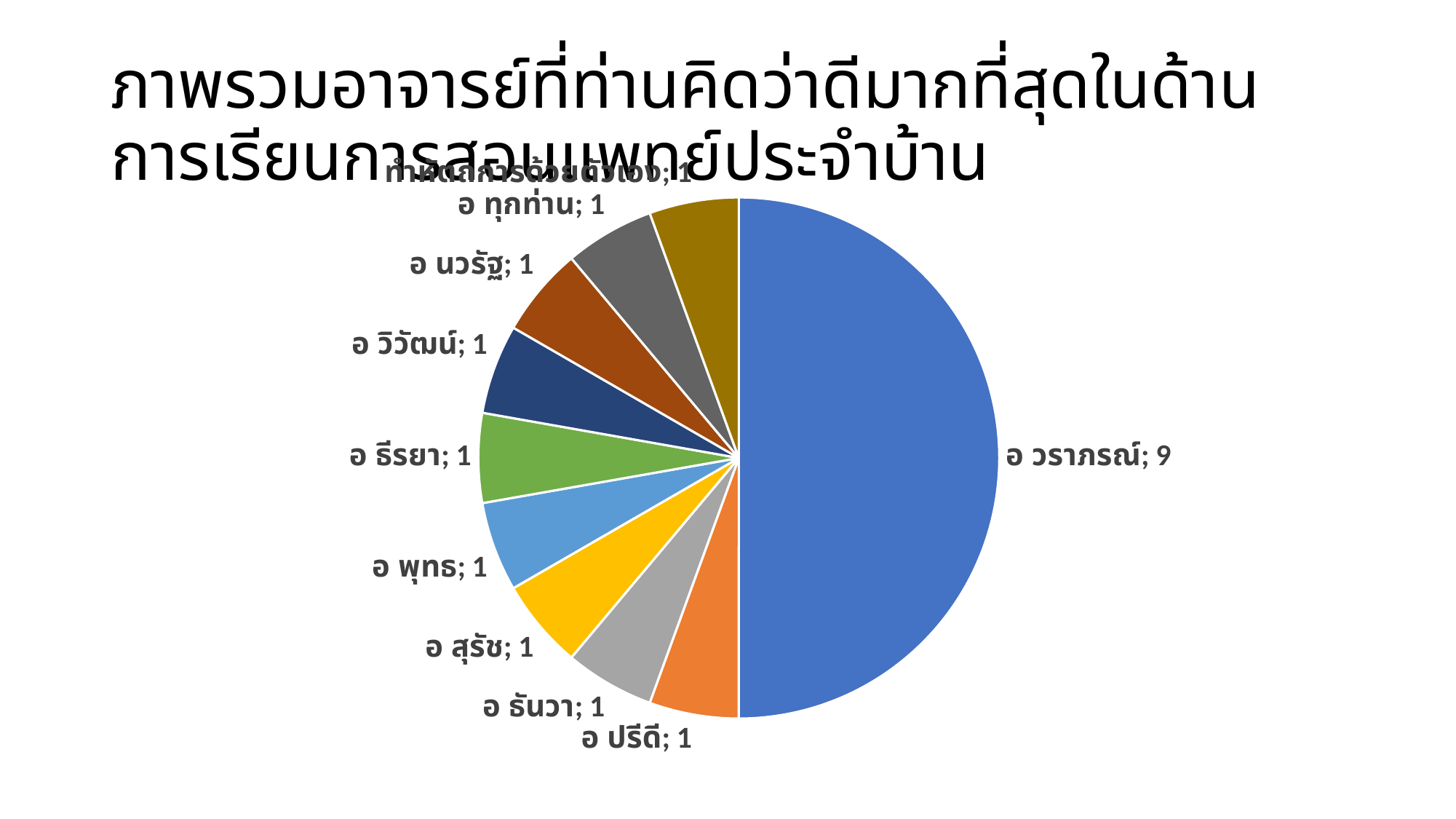
How many slices does the pie chart have? 10 What colour is the slice for อ วราภรณ์? blue What is the difference between the values for อ วราภรณ์ and อ สุรัช? 8 What is the value for อ ปรีดี? 1 What is the value for อ ธีรยา? 1 What kind of chart is shown on the slide? pie chart What is the value for อ นวรัฐ? 1 What share of the pie does อ วราภรณ์ represent? 50% Which is larger, the value for อ วราภรณ์ or the value for อ พุทธ? อ วราภรณ์ Which category has the largest slice of the pie? อ วราภรณ์ What colour is the slice for อ สุรัช? yellow What is the value for อ วราภรณ์? 9